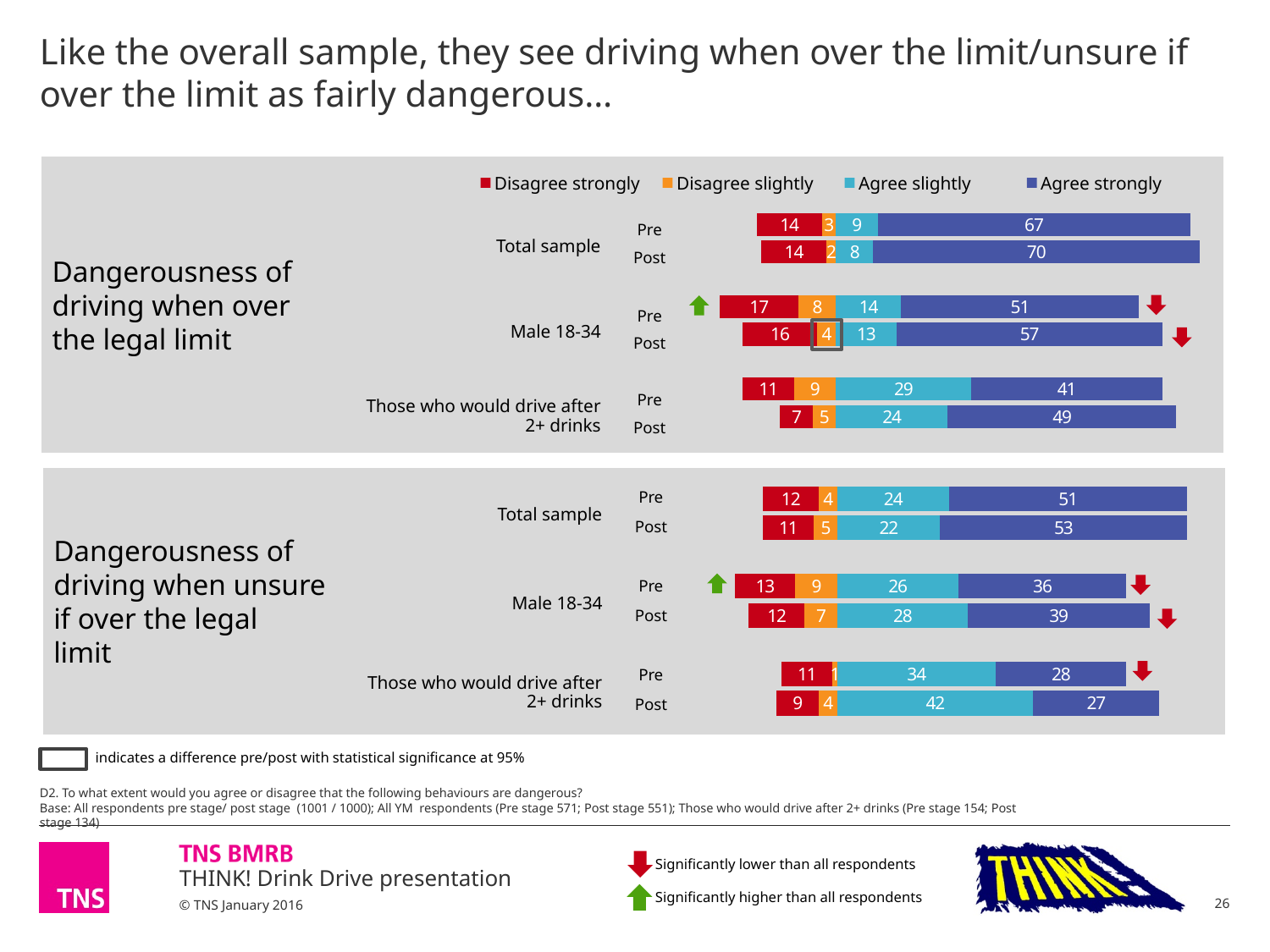
In the bottom chart (Dangerousness of driving when unsure if over the legal limit), what is the Agree strongly value for Male 18-34 Post? 39 In the bottom chart (Dangerousness of driving when unsure if over the legal limit), which bar has the lowest Agree strongly value? Those who would drive after 2+ drinks Post In the top chart (Dangerousness of driving when over the legal limit), what is the total of the Those who would drive after 2+ drinks Post bar? 85 In the top chart (Dangerousness of driving when over the legal limit), which bar has the highest Agree strongly value? Total sample Post In the top chart (Dangerousness of driving when over the legal limit), what is the difference between the Agree strongly values for Male 18-34 Post and Male 18-34 Pre? 6 In the bottom chart (Dangerousness of driving when unsure if over the legal limit), is the Agree slightly value larger for Those who would drive after 2+ drinks Pre or Post? Post How many series does the legend list? 4 In the bottom chart (Dangerousness of driving when unsure if over the legal limit), what is the Agree slightly value for Those who would drive after 2+ drinks Post? 42 What type of chart is used on this slide? Stacked bar chart Which legend entry is shown in red? Disagree strongly In the top chart (Dangerousness of driving when over the legal limit), what is the Disagree strongly value for Male 18-34 Pre? 17 In the top chart (Dangerousness of driving when over the legal limit), what is the Agree strongly value for the Total sample Post bar? 70